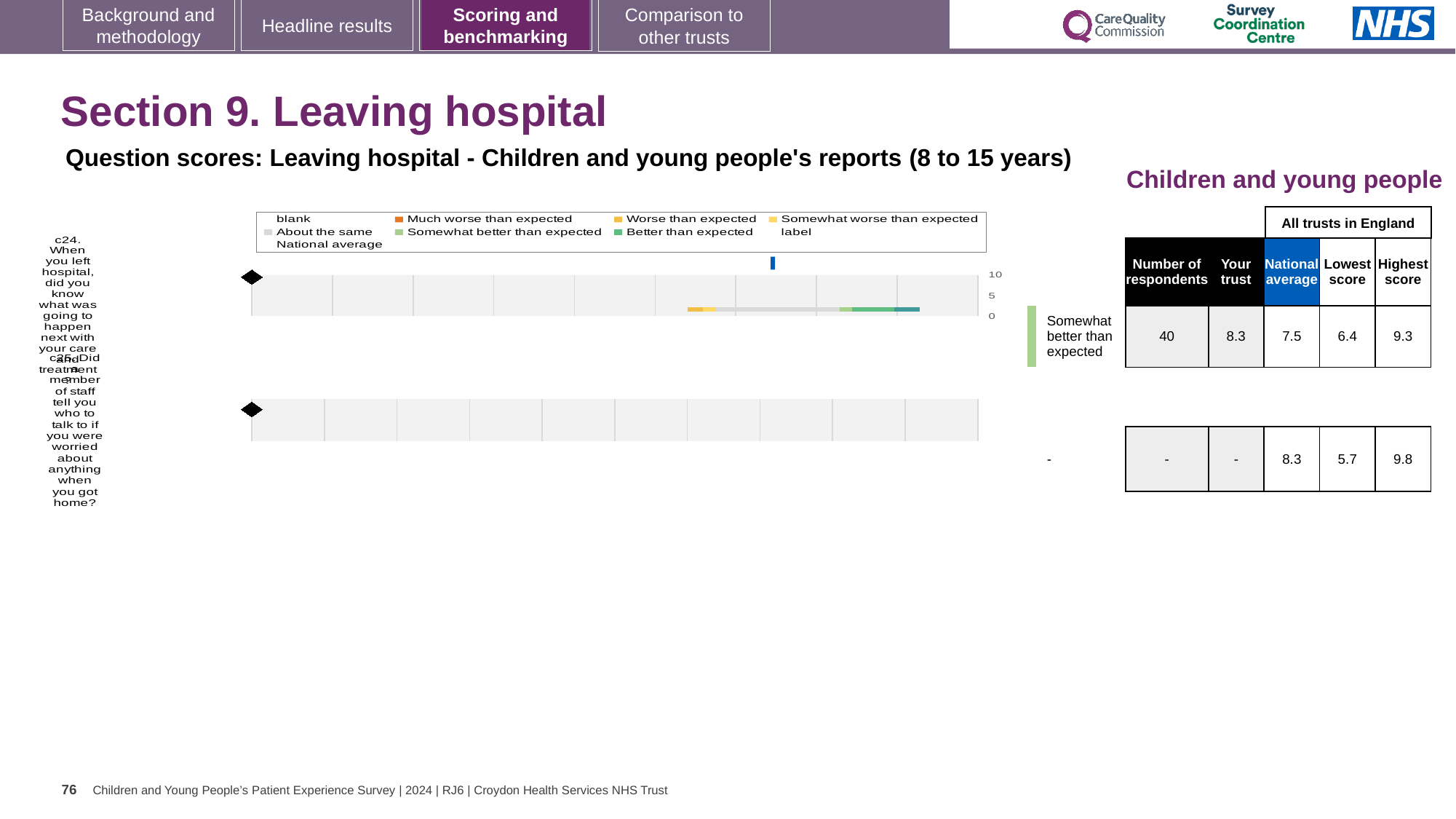
Is the trust's score for question c24 greater or less than 5 on the chart axis? greater What is the national average score for question c25 (Did a member of staff tell you who to talk to if you were worried about anything when you got home)? 8.3 For question c24, which is higher: the trust's score or the national average? Your trust How many questions are plotted in the Leaving hospital chart? 2 What is the highest score among all trusts in England for question c24? 9.3 What type of chart is used to show the question scores for Leaving hospital? bar chart What is the national average score for question c24? 7.5 What is the lowest score among all trusts in England for question c25? 5.7 How many respondents answered question c24? 40 What is the 'Your trust' score for question c24 (When you left hospital, did you know what was going to happen next with your care and treatment)? 8.3 What benchmarking category is the trust's result for question c24 labelled as? Somewhat better than expected What is the difference between the highest and lowest trust scores for question c24? 2.9